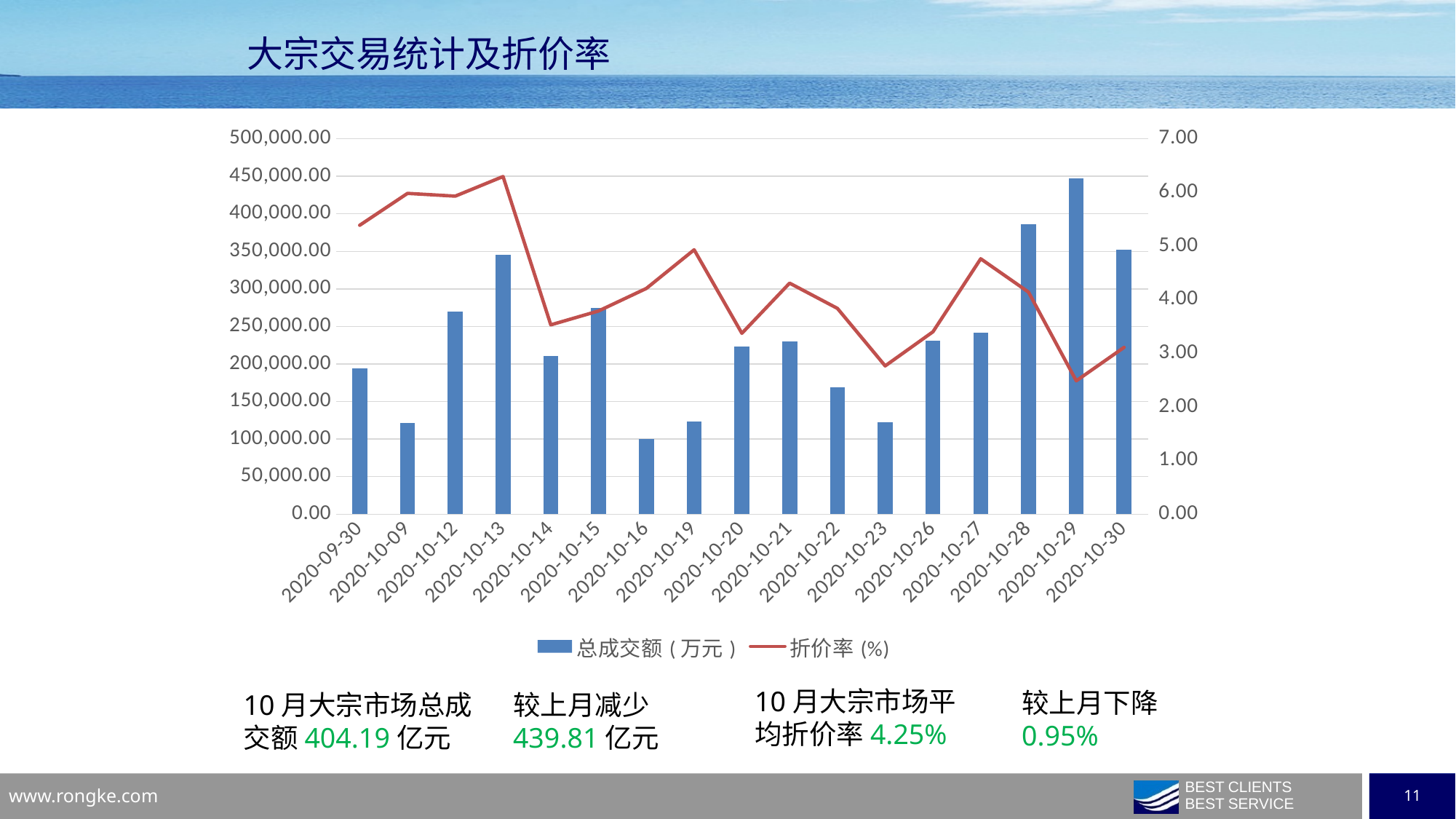
How many series does the legend list? 2 Which date has the lowest bar for 总成交额（万元）? 2020-10-16 Which date has the larger 总成交额（万元）bar, 2020-10-28 or 2020-10-30? 2020-10-28 Is the 总成交额（万元）bar for 2020-10-29 greater or less than 400,000.00? greater Does the 折价率 (%) line rise or fall from 2020-10-13 to 2020-10-14? fall Is the 折价率 (%) value for 2020-10-29 greater or less than 3.00? less On which date does the 折价率 (%) line reach its lowest point? 2020-10-29 How many dates are plotted along the x axis? 17 Which date has the highest bar for 总成交额（万元）? 2020-10-29 On which date does the 折价率 (%) line reach its highest point? 2020-10-13 What kind of chart is shown on the slide? A combined bar and line chart Is the 总成交额（万元）bar for 2020-10-16 greater or less than 150,000.00? less